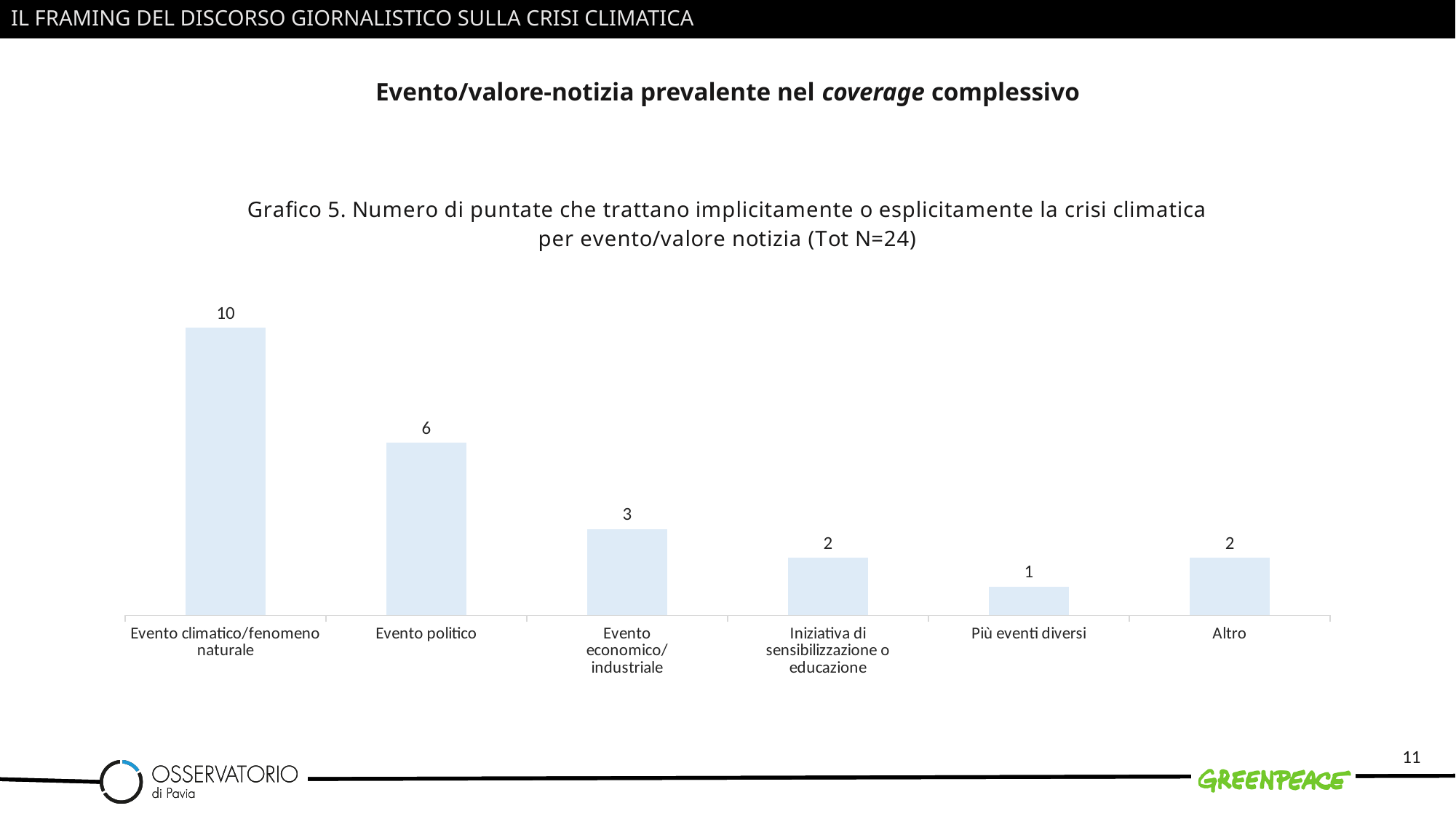
How many categories are shown on the x axis? 6 What is the difference between the values for Evento climatico/fenomeno naturale and Evento politico? 4 Which category has the highest value? Evento climatico/fenomeno naturale Which is larger, the value for Evento politico or the value for Evento economico/industriale? Evento politico What kind of chart is this? Bar chart What is the value for Più eventi diversi? 1 Which two categories both have a value of 2? Iniziativa di sensibilizzazione o educazione and Altro Which category has the lowest value? Più eventi diversi What is the value for Evento economico/industriale? 3 What is the value for Evento climatico/fenomeno naturale? 10 What is the value for Evento politico? 6 What is the total N stated in the chart title? 24